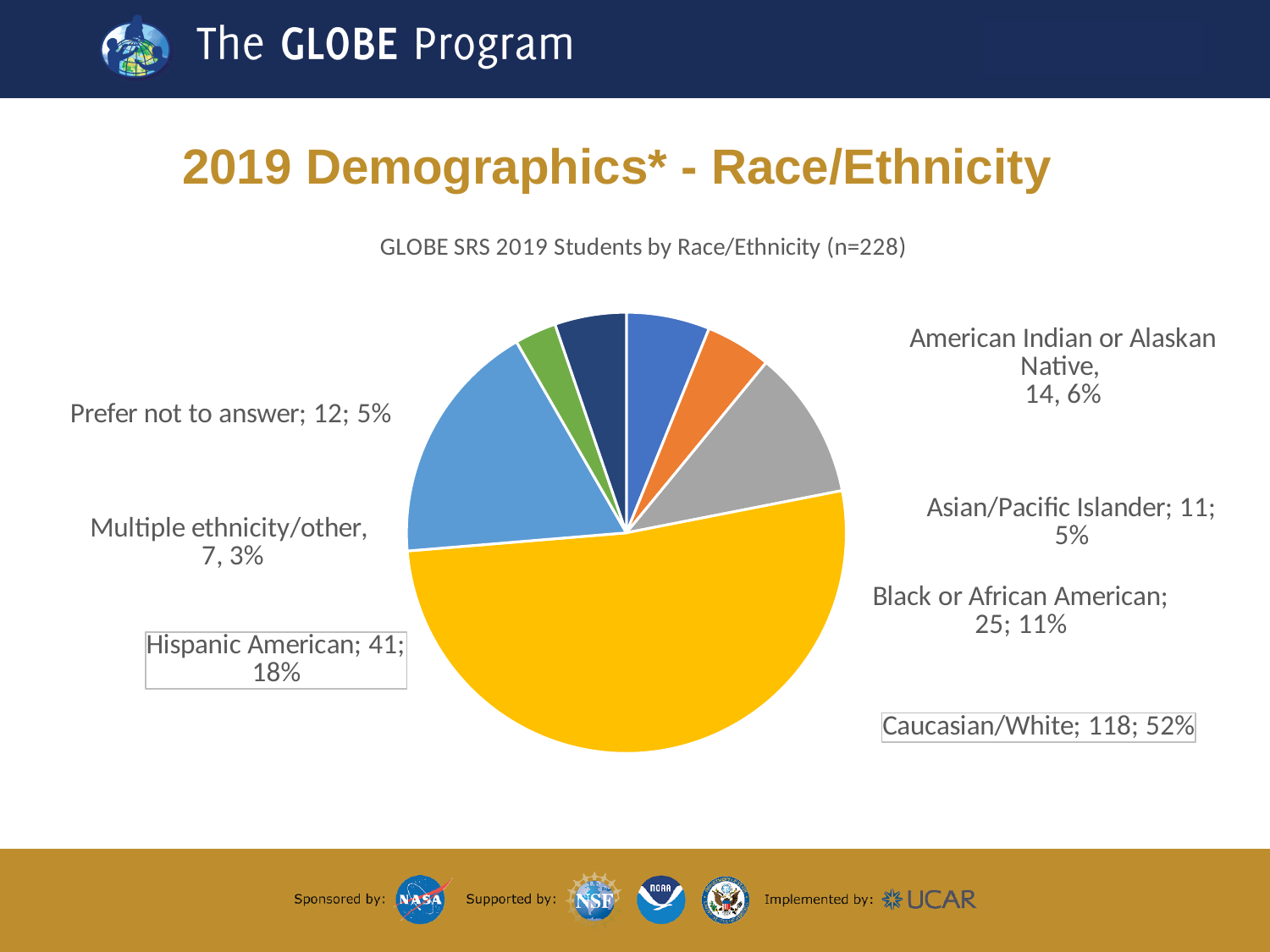
What percentage of students are Hispanic American? 18% How many categories are shown in the pie chart? 7 What is the difference in student count between Caucasian/White and Hispanic American? 77 What is the title of the chart? GLOBE SRS 2019 Students by Race/Ethnicity (n=228) What kind of chart is shown on the slide? pie chart Which is larger, the count for Black or African American or the count for Prefer not to answer? Black or African American How many students are Black or African American? 25 How many students selected Asian/Pacific Islander? 11 Which category has the smallest slice of the pie? Multiple ethnicity/other Which category has the largest slice of the pie? Caucasian/White How many students are Caucasian/White? 118 What share of the pie is American Indian or Alaskan Native? 6%